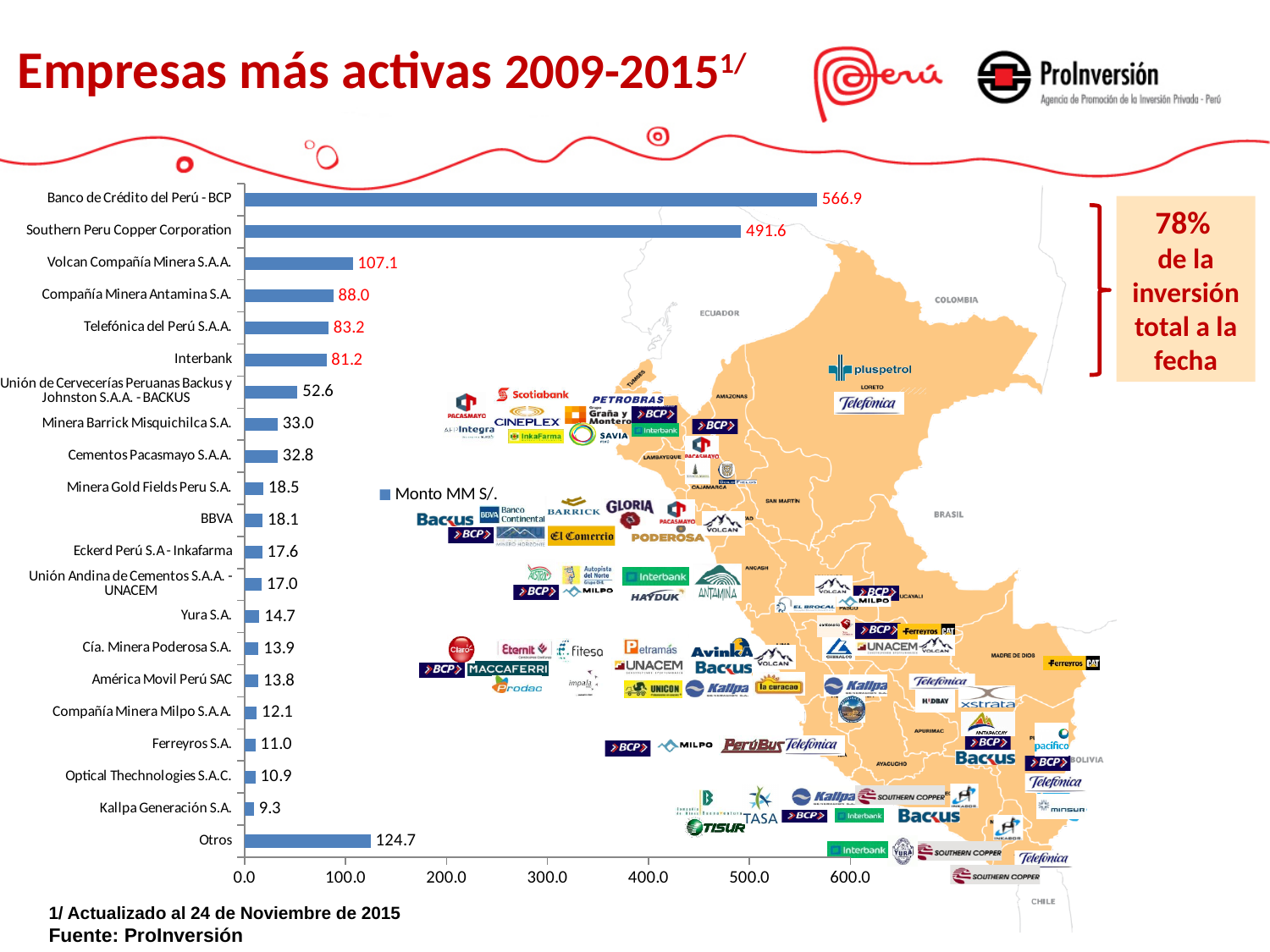
How many categories (bars) are shown in the chart? 21 Is the value for Southern Peru Copper Corporation greater or less than 400.0? greater What is the difference between the values for Banco de Crédito del Perú - BCP and Southern Peru Copper Corporation? 75.3 How many series does the legend list? 1 What is the value for Telefónica del Perú S.A.A.? 83.2 What is the value for Banco de Crédito del Perú - BCP? 566.9 Which category has the lowest value in the chart? Kallpa Generación S.A. Which company has the highest value in the chart? Banco de Crédito del Perú - BCP What kind of chart is shown on the slide? Bar chart Which is larger, the value for Volcan Compañía Minera S.A.A. or the value for Compañía Minera Antamina S.A.? Volcan Compañía Minera S.A.A. What is the legend entry of the chart? Monto MM S/. What is the value for Otros? 124.7